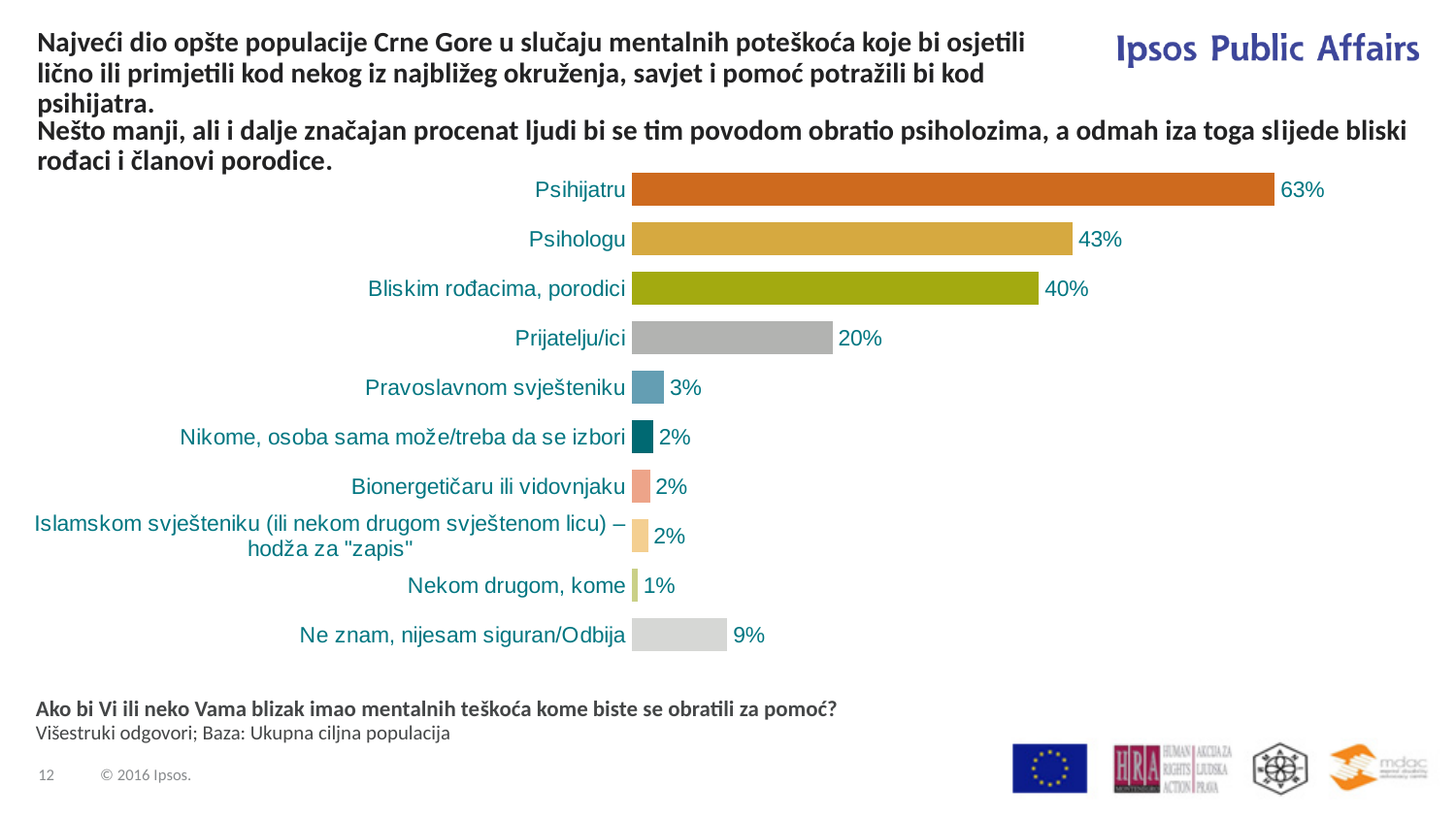
What percentage of respondents would seek help from a psychiatrist (Psihijatru)? 63% Which is larger, the value for Pravoslavnom svješteniku or the value for Ne znam, nijesam siguran/Odbija? Ne znam, nijesam siguran/Odbija Which category has the highest value in the chart? Psihijatru What colour is the bar for Psihijatru? Orange What is the value shown for Psihologu? 43% How many categories are shown in the chart? 10 What is the value for Ne znam, nijesam siguran/Odbija? 9% What type of chart is shown on the slide? Bar chart Which category has the lowest value in the chart? Nekom drugom, kome What percentage is shown for Prijatelju/ici? 20% What is the difference between the values for Psihijatru and Psihologu? 20 percentage points What is the difference between the values for Bliskim rođacima, porodici and Prijatelju/ici? 20 percentage points